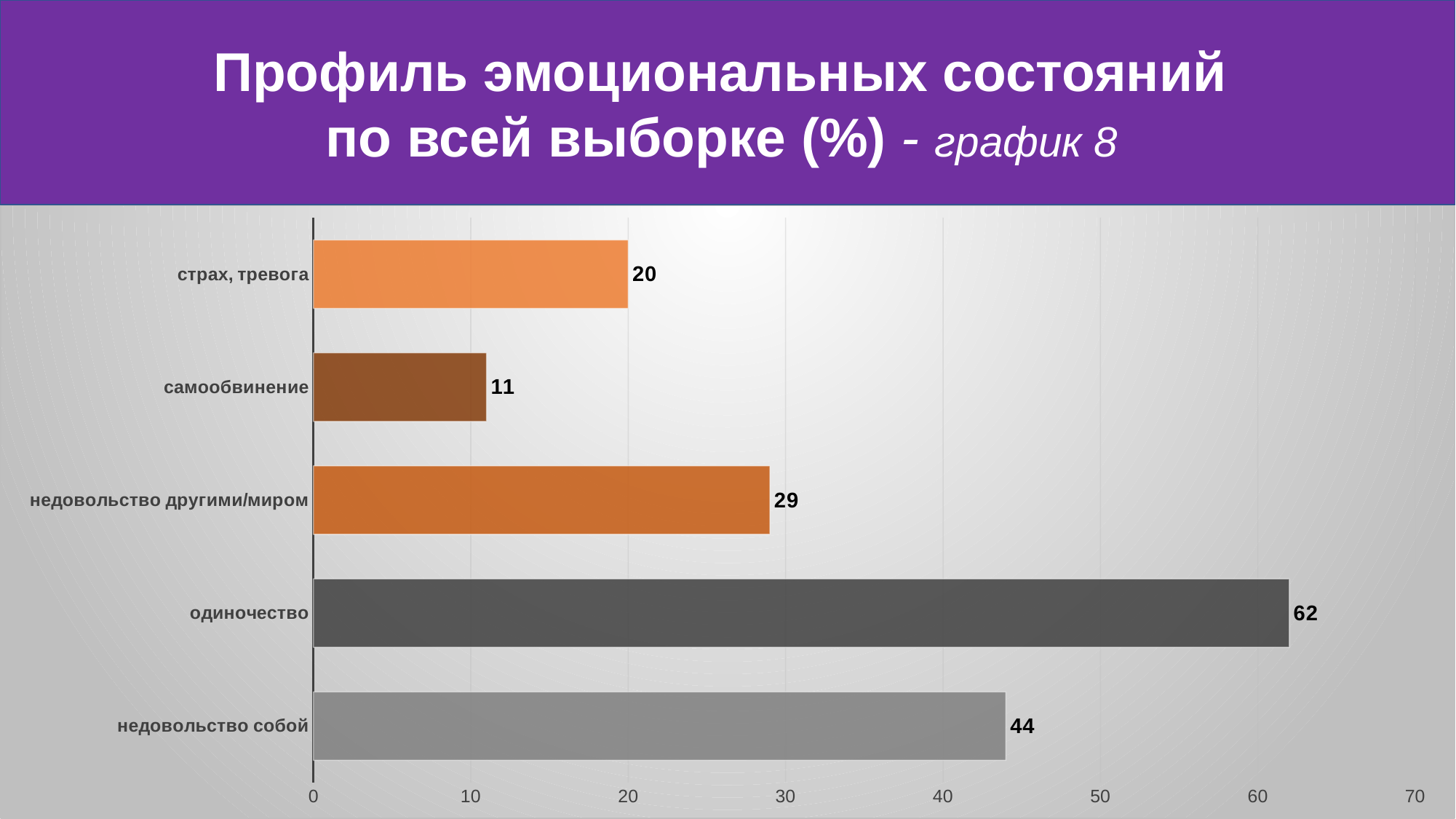
What is the value for одиночество? 62 What is the highest value shown on the x axis? 70 What is the value for самообвинение? 11 Which category has the highest value? одиночество Which category has the lowest value? самообвинение Is the value for недовольство другими/миром greater or less than 30? less What is the difference between the values for одиночество and недовольство собой? 18 What is the value for страх, тревога? 20 Which is larger: the value for недовольство другими/миром or the value for страх, тревога? недовольство другими/миром What kind of chart is shown on the slide? bar chart What is the value for недовольство собой? 44 How many categories are shown in the chart? 5